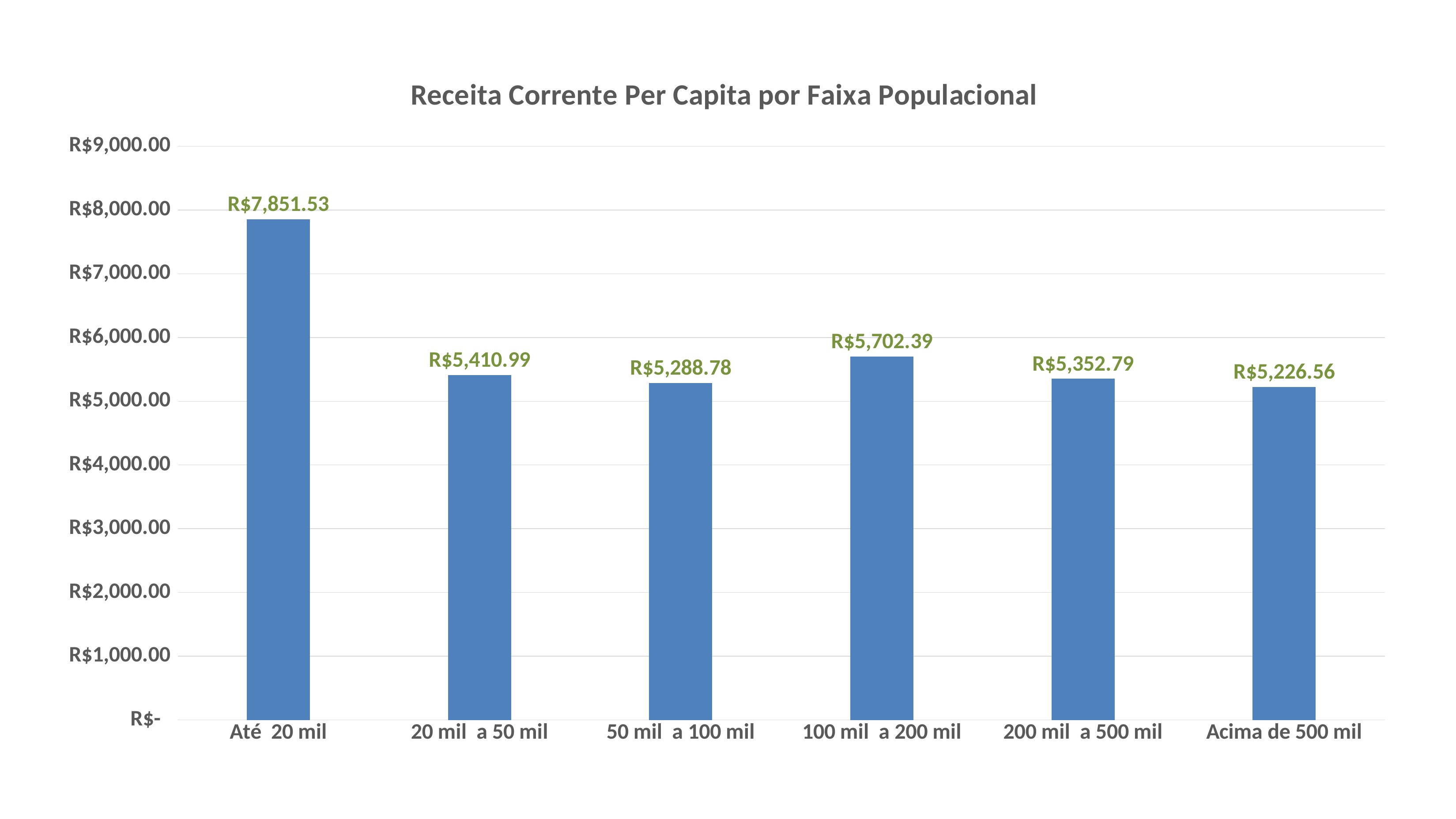
What is the value shown for 'Acima de 500 mil'? R$5,226.56 Which is larger, the value for '200 mil a 500 mil' or the value for '50 mil a 100 mil'? 200 mil a 500 mil What is the value for the '50 mil a 100 mil' category? R$5,288.78 Which population range has the lowest Receita Corrente Per Capita? Acima de 500 mil How many population ranges are shown on the chart? 6 What is the difference between the values for 'Até 20 mil' and 'Acima de 500 mil'? R$2,624.97 Is the value for '20 mil a 50 mil' greater or less than R$6,000.00? less Which population range has the highest Receita Corrente Per Capita? Até 20 mil What is the Receita Corrente Per Capita for the 'Até 20 mil' population range? R$7,851.53 What is the difference between the values for '100 mil a 200 mil' and '20 mil a 50 mil'? R$291.40 What type of chart is shown on the slide? Bar chart What is the value shown for the '100 mil a 200 mil' category? R$5,702.39